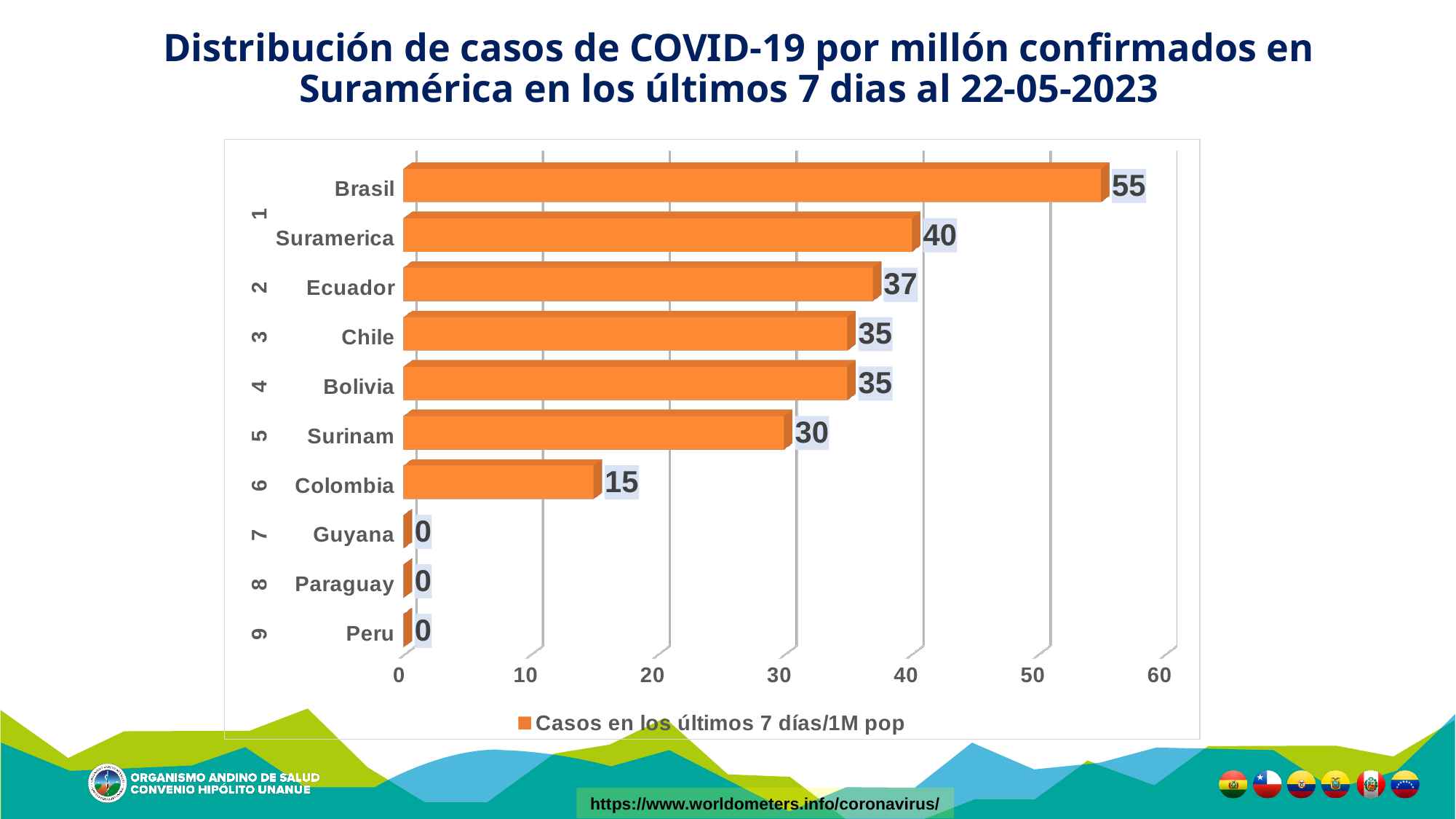
How many categories are shown on the chart? 10 What is the value for Ecuador? 37 What is the value for Brasil? 55 What is the difference between the values for Ecuador and Colombia? 22 What kind of chart is shown on the slide? Bar chart What is the difference between the values for Brasil and Surinam? 25 How many categories have a value of 0? 3 Which has a larger value, Suramerica or Chile? Suramerica What is the value for Suramerica? 40 How many series does the legend list? 1 Which category has the highest value? Brasil What is the value for Colombia? 15